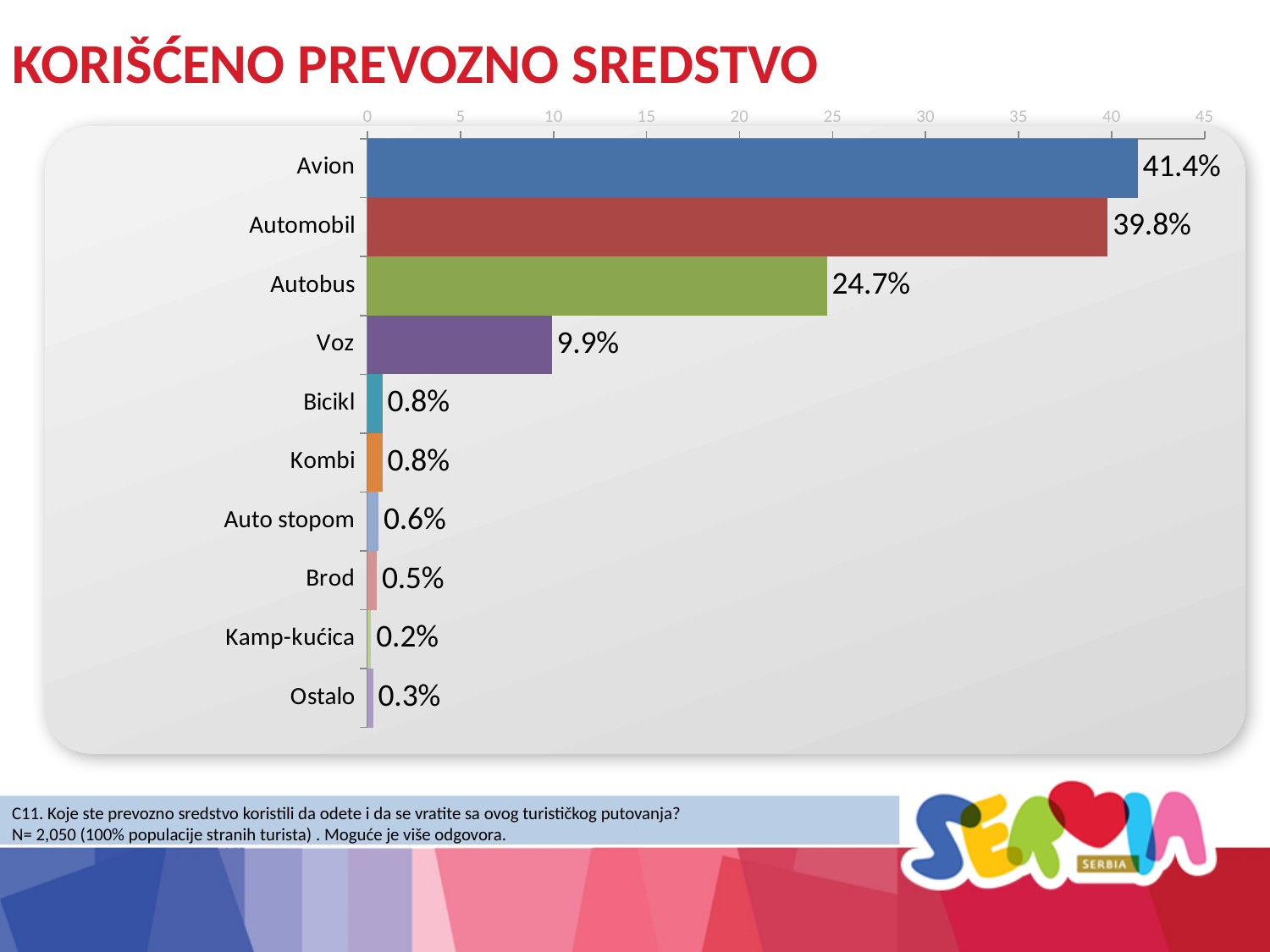
What is the difference between the values for Autobus and Voz? 14.8% Is the value for Automobil greater or less than 35? greater Which category has the highest value? Avion How many categories are shown in the chart? 10 What is the value for Brod? 0.5% Which category has the lowest value? Kamp-kućica What is the value for Avion? 41.4% What kind of chart is shown on the slide? Bar chart Which is larger, the value for Automobil or the value for Autobus? Automobil What is the value for Voz? 9.9% What is the difference between the values for Avion and Automobil? 1.6% What is the value for Autobus? 24.7%